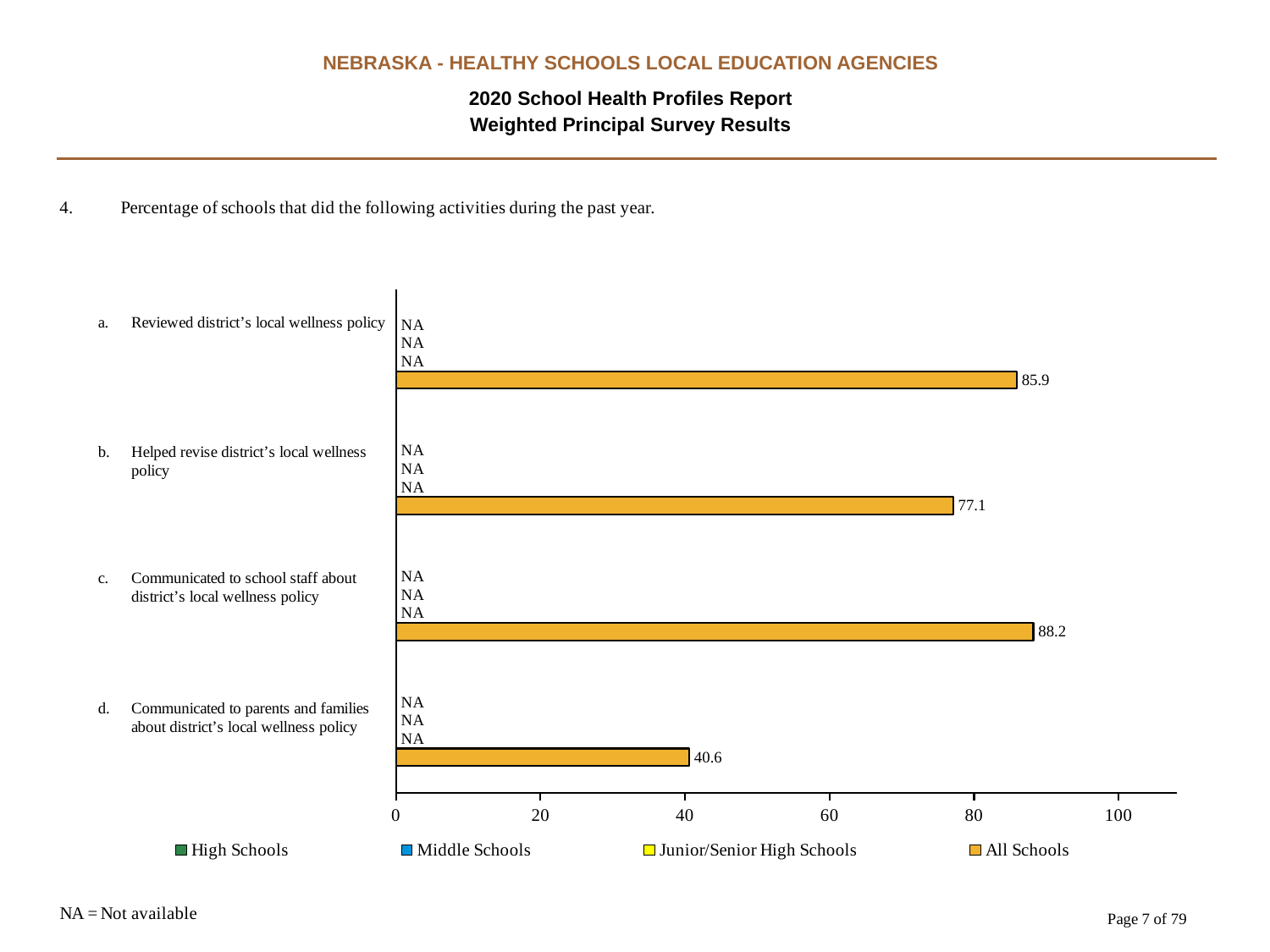
What is the All Schools value for 'Helped revise district's local wellness policy'? 77.1 How many series does the legend list? 4 What value is shown for High Schools for 'Reviewed district's local wellness policy'? NA How many activities are listed on the chart? 4 What is the All Schools value for 'Communicated to parents and families about district's local wellness policy'? 40.6 What is the All Schools value for 'Reviewed district's local wellness policy'? 85.9 Which activity has the lowest All Schools percentage? Communicated to parents and families about district's local wellness policy What kind of chart is shown? Bar chart Which activity has the highest All Schools percentage? Communicated to school staff about district's local wellness policy What is the All Schools value for 'Communicated to school staff about district's local wellness policy'? 88.2 Which is larger for All Schools: 'Reviewed district's local wellness policy' or 'Helped revise district's local wellness policy'? Reviewed district's local wellness policy What is the difference between the All Schools values for 'Communicated to school staff' and 'Communicated to parents and families'? 47.6